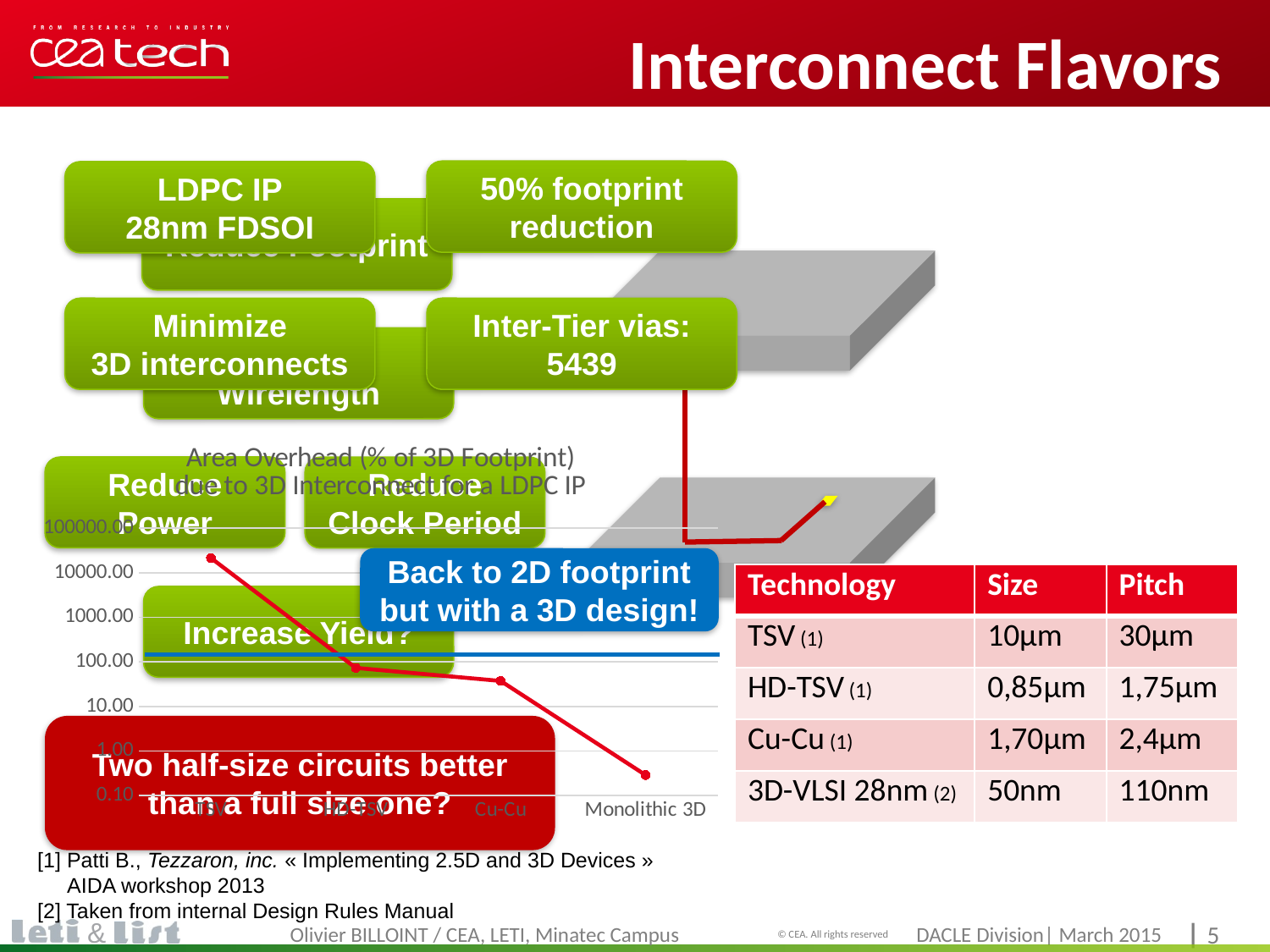
Is the area overhead value for Cu-Cu greater or less than 10.00? greater Is the area overhead value for Cu-Cu greater or less than 100.00? less Which technology has the lowest area overhead in the chart? Monolithic 3D Which technology has the highest area overhead in the chart? TSV Which has the larger area overhead, HD-TSV or Monolithic 3D? HD-TSV Do the area overhead values rise or fall from TSV to Monolithic 3D along the x axis? fall Is the area overhead value for TSV greater or less than 10000.00? greater Which has the larger area overhead, TSV or Monolithic 3D? TSV What kind of chart is the 'Area Overhead (% of 3D Footprint)' chart? line chart How many technology categories are shown on the x axis of the area overhead chart? 4 What is the title of the line chart on the slide? Area Overhead (% of 3D Footprint) due to 3D Interconnect for a LDPC IP